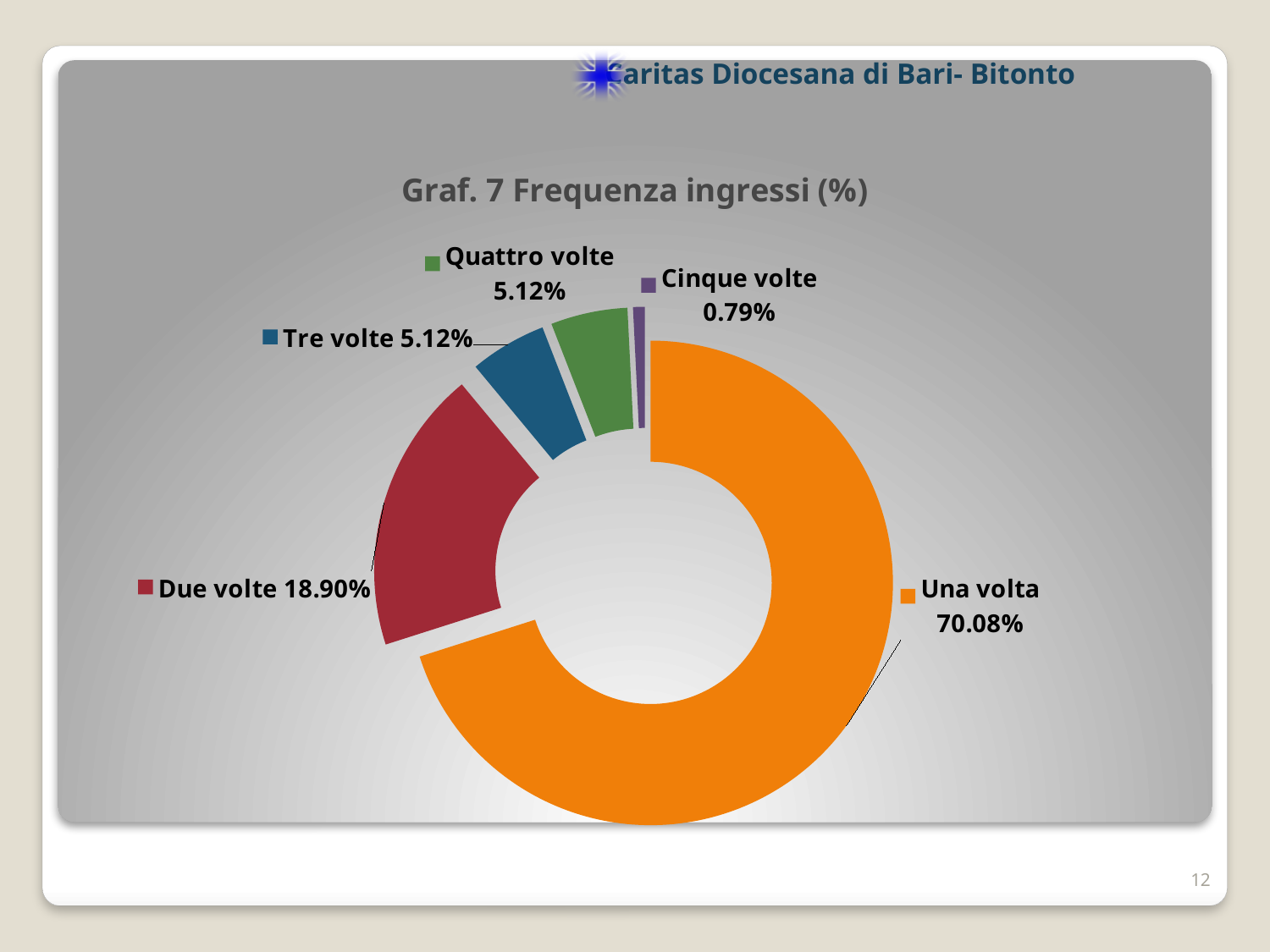
Which category has the largest share? Una volta What is the title of the chart? Graf. 7 Frequenza ingressi (%) Which category has the smallest share? Cinque volte What colour is the Una volta slice? Orange What kind of chart is shown on the slide? Doughnut (pie) chart What is the value for Una volta? 70.08% Which is larger, Due volte or Quattro volte? Due volte What is the value for Due volte? 18.90% What is the value for Tre volte? 5.12% What is the difference between the values for Una volta and Due volte? 51.18% What is the value for Cinque volte? 0.79% How many categories are shown in the chart? 5